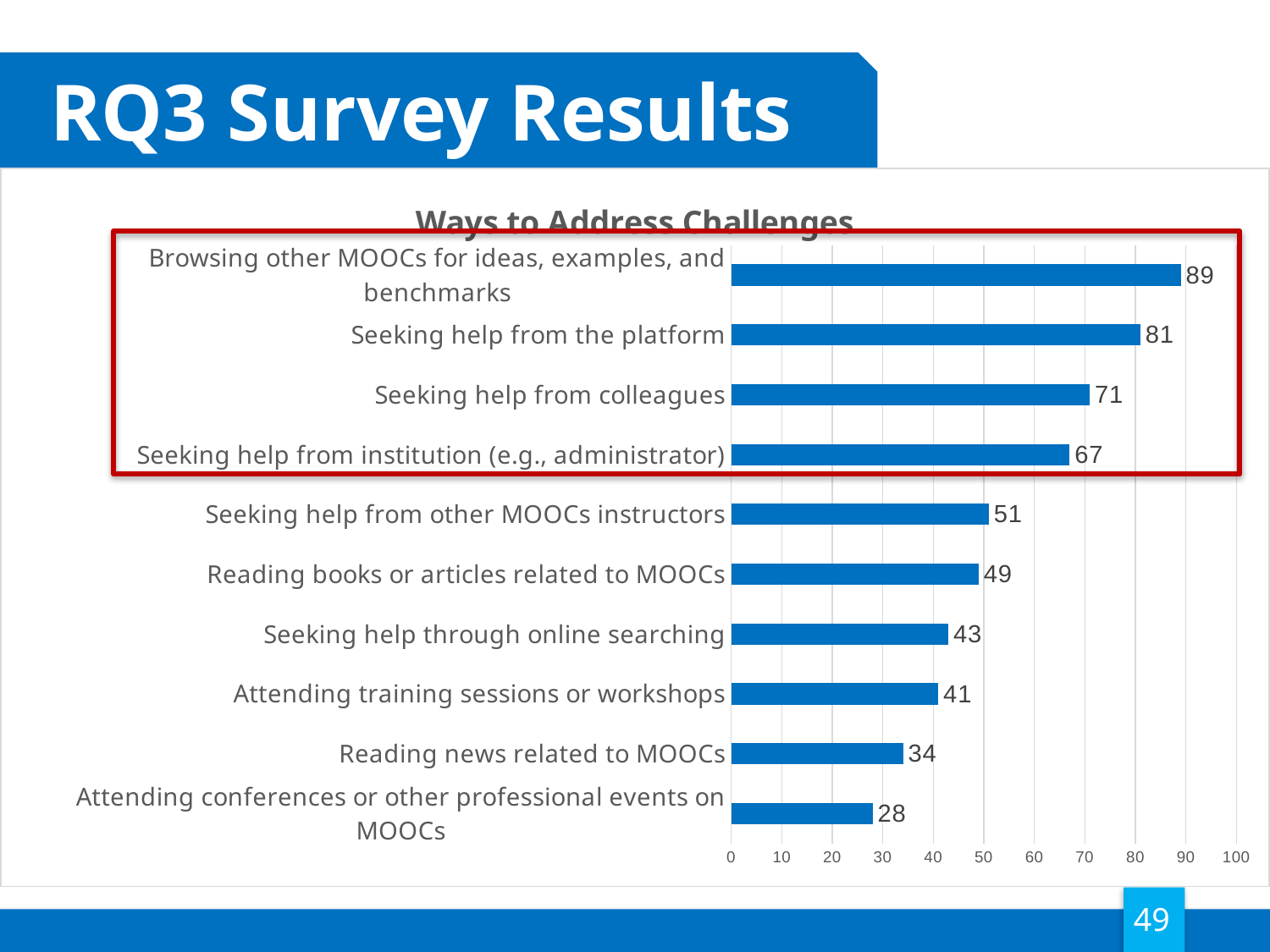
Is the value for "Seeking help from the platform" greater or less than 70? greater What is the difference between the values for "Seeking help from colleagues" and "Seeking help from institution (e.g., administrator)"? 4 Which is larger: the value for "Seeking help from other MOOCs instructors" or "Seeking help through online searching"? Seeking help from other MOOCs instructors What is the title of the chart? Ways to Address Challenges How many categories are shown in the chart? 10 What is the difference between the values for "Browsing other MOOCs for ideas, examples, and benchmarks" and "Reading news related to MOOCs"? 55 What is the value for "Attending training sessions or workshops"? 41 What is the value for "Reading books or articles related to MOOCs"? 49 What is the value for "Seeking help from the platform"? 81 Which category has the highest value? Browsing other MOOCs for ideas, examples, and benchmarks Which category has the lowest value? Attending conferences or other professional events on MOOCs What kind of chart is shown on the slide? bar chart